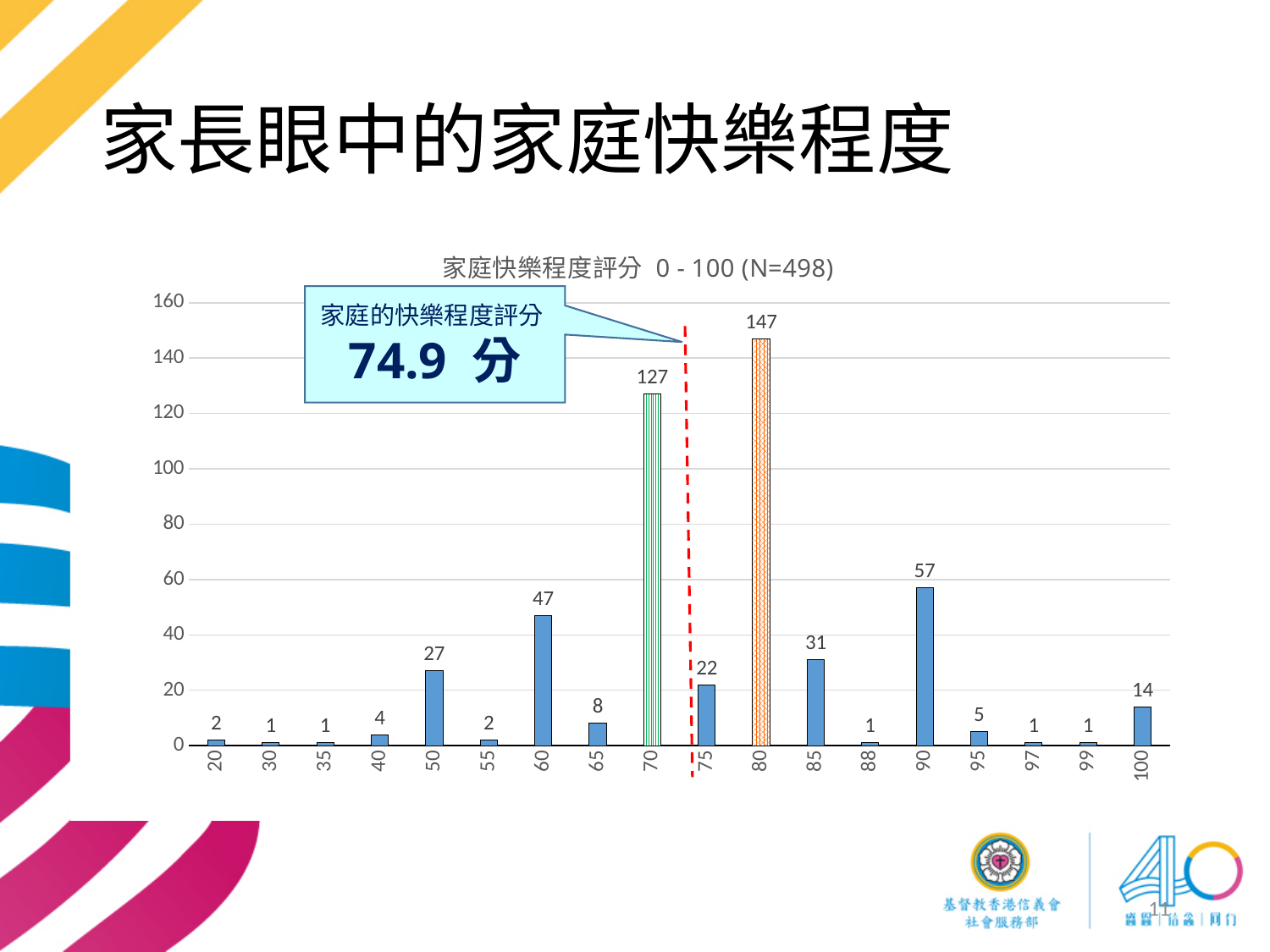
Which score category has the highest value? 80 What average family happiness score is shown in the callout box? 74.9 分 What is the difference between the values for score categories 90 and 85? 26 How many score categories are shown on the x axis? 18 What is the title of the chart? 家庭快樂程度評分 0 - 100 (N=498) What is the value for the score category 100? 14 What is the value for the score category 80? 147 What type of chart is shown on the slide? bar chart Which has a larger value, score category 60 or score category 85? 60 What is the value for the score category 90? 57 What is the difference between the values for score categories 80 and 70? 20 What is the value for the score category 70? 127